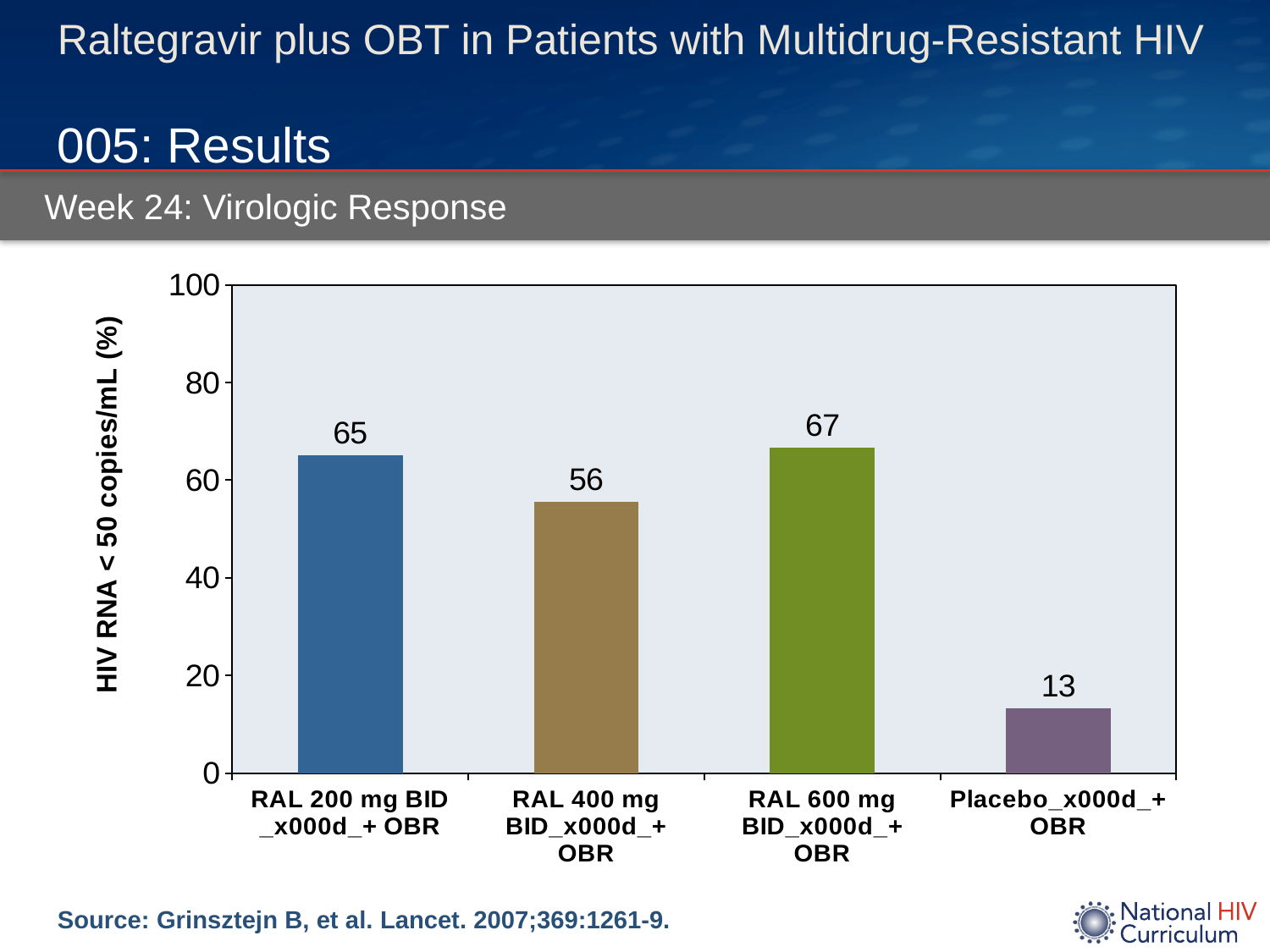
What is the difference between the values for RAL 600 mg BID + OBR and Placebo + OBR? 54 Which category has the lowest value? Placebo + OBR Which category has the highest value? RAL 600 mg BID + OBR What is the value for RAL 400 mg BID + OBR? 56 What is the label of the y axis? HIV RNA < 50 copies/mL (%) What is the difference between the values for RAL 200 mg BID + OBR and RAL 400 mg BID + OBR? 9 What kind of chart is shown on the slide? bar chart What is the value for RAL 600 mg BID + OBR? 67 What is the value for Placebo + OBR? 13 What is the value for RAL 200 mg BID + OBR? 65 How many categories are shown on the x axis? 4 Which is larger, the value for RAL 400 mg BID + OBR or the value for RAL 600 mg BID + OBR? RAL 600 mg BID + OBR